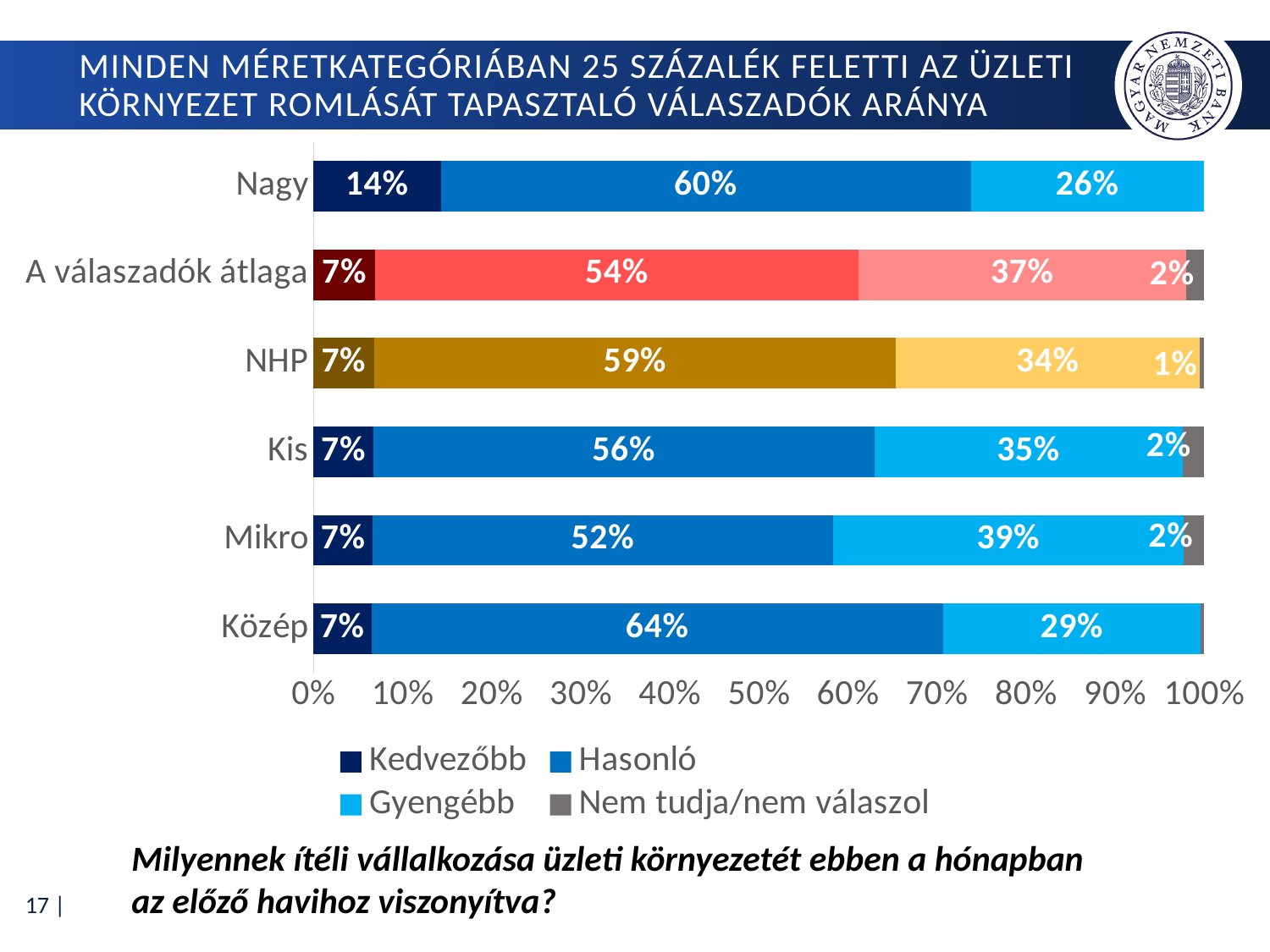
What is the Kedvezőbb value for Nagy? 14% Which category has the highest Hasonló value? Közép Which legend entry is shown in the darkest colour? Kedvezőbb What is the Hasonló value for Nagy? 60% What is the Gyengébb value for Mikro? 39% Which is larger, the Hasonló value for Kis or for Mikro? Kis How many series does the legend list? 4 What kind of chart is shown on the slide? Stacked bar chart How many categories are shown on the chart? 6 What is the difference between the Gyengébb values for Mikro and Nagy? 13% What is the Nem tudja/nem válaszol value for NHP? 1% Which category has the lowest Gyengébb value? Nagy